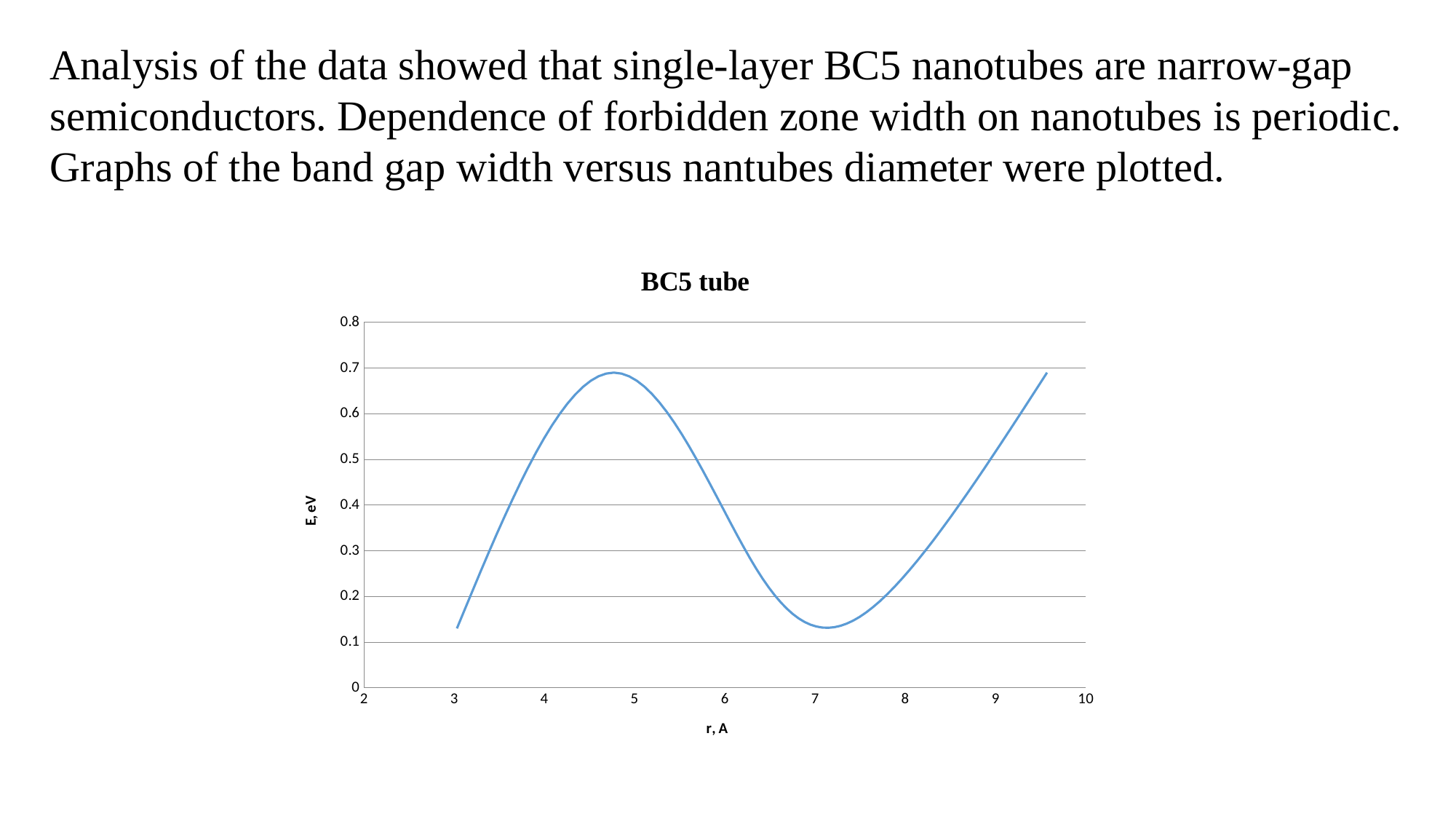
Is the highest value of E on the curve greater or less than 0.6? greater Is the value of E at r = 7 greater or less than 0.2? less What is the label of the vertical axis of the chart? E, eV Is the lowest value of E on the curve greater or less than 0.2? less What kind of chart is shown on the slide? line chart Does the value of E rise or fall as r increases from 5 to 7? fall What is the title of the chart? BC5 tube Does the value of E rise or fall as r increases from 3 to 5? rise Is the value of E at r = 5 larger or smaller than the value at r = 7? larger